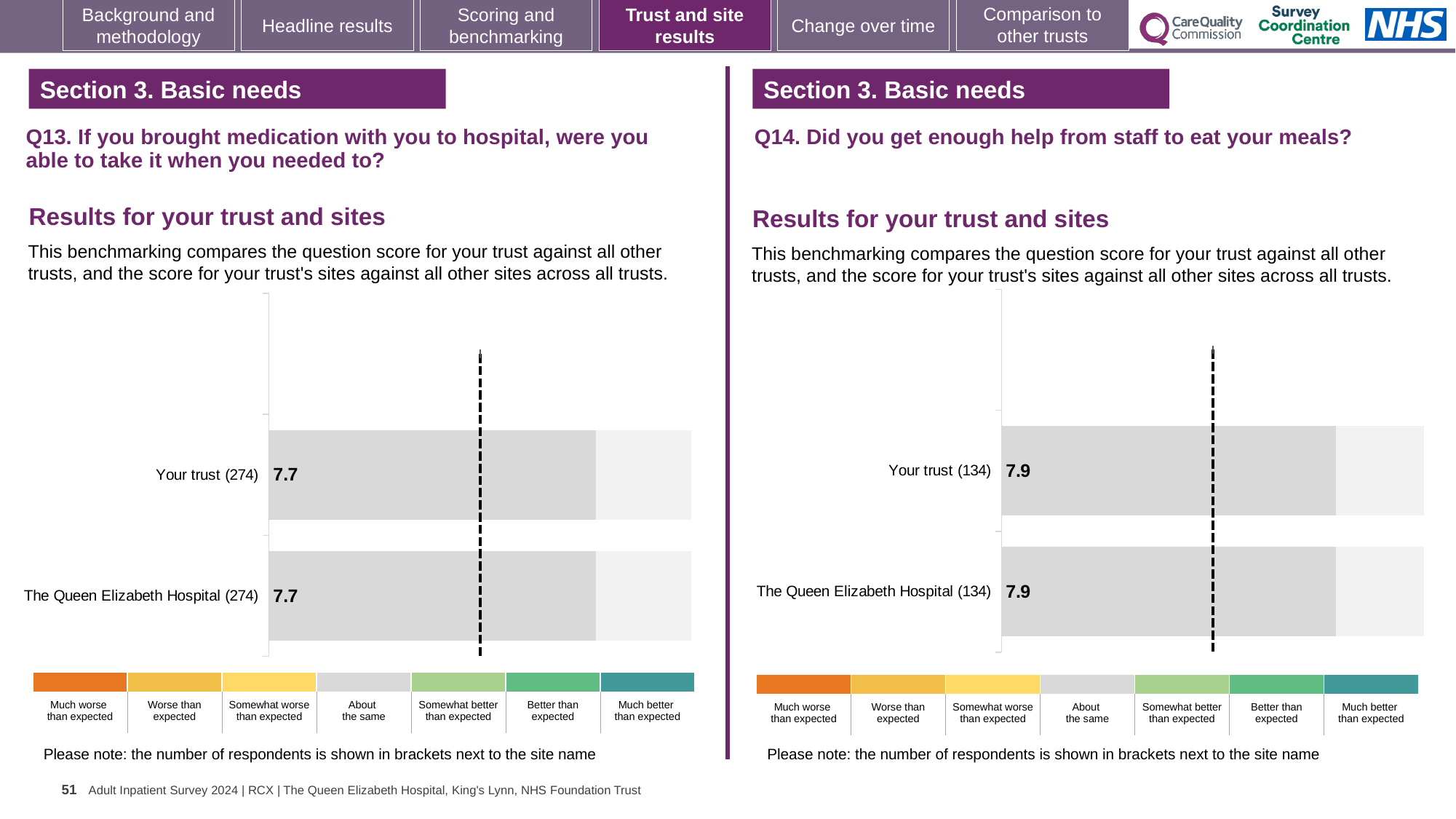
How many bars are plotted in the Q13 chart on the left? 2 In the Q14 chart on the right, how many respondents are shown in brackets for Your trust? 134 Is the Your trust score in the Q13 chart on the left larger or smaller than the Your trust score in the Q14 chart on the right? Smaller What is the difference between the Your trust score in the Q14 chart on the right and the Your trust score in the Q13 chart on the left? 0.2 What kind of chart is used for the Q14 results on the right? Bar chart In the Q14 chart on the right, what is the score for The Queen Elizabeth Hospital? 7.9 How many bars are plotted in the Q14 chart on the right? 2 In the Q13 chart on the left, what is the score for Your trust? 7.7 In the Q13 chart on the left, what is the score for The Queen Elizabeth Hospital? 7.7 In the Q13 chart on the left, how many respondents are shown in brackets for The Queen Elizabeth Hospital? 274 How many benchmark categories are shown in the colour key below the Q13 chart on the left? 7 In the Q14 chart on the right, what is the score for Your trust? 7.9